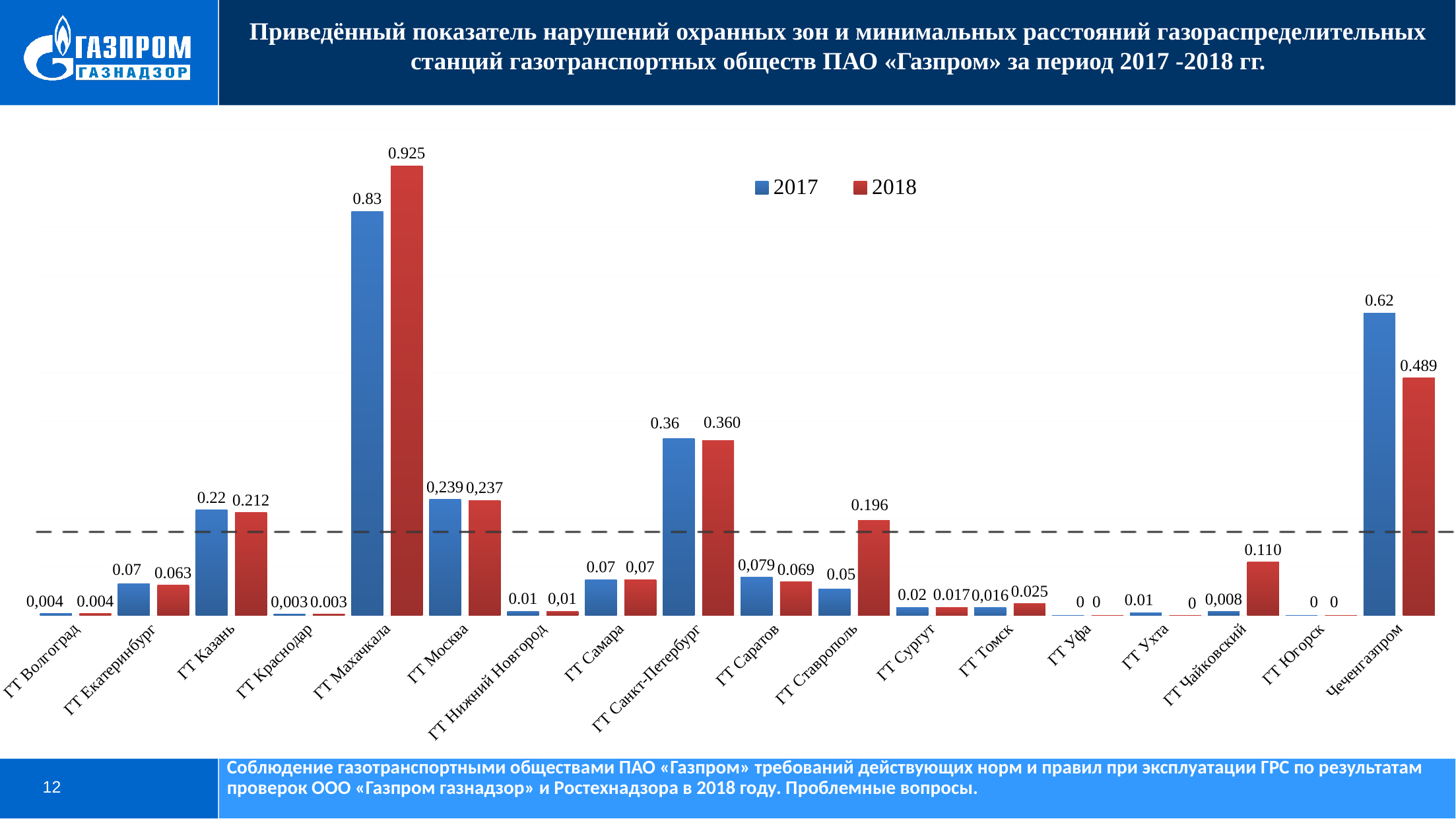
What is the 2018 value for ГТ Махачкала? 0.925 What is the 2017 value for Чеченгазпром? 0.62 How many series does the legend list? 2 What type of chart is shown on the slide? bar chart Which category has the highest 2017 value? ГТ Махачкала What is the 2018 value for ГТ Ставрополь? 0.196 Which category has the highest 2018 value? ГТ Махачкала What are the legend entries of the chart? 2017 and 2018 How many categories (companies) are shown on the x axis? 18 Which is larger for Чеченгазпром: the 2017 value or the 2018 value? 2017 What is the 2017 value for ГТ Казань? 0.22 What is the difference between the 2018 and 2017 values for ГТ Махачкала? 0.095